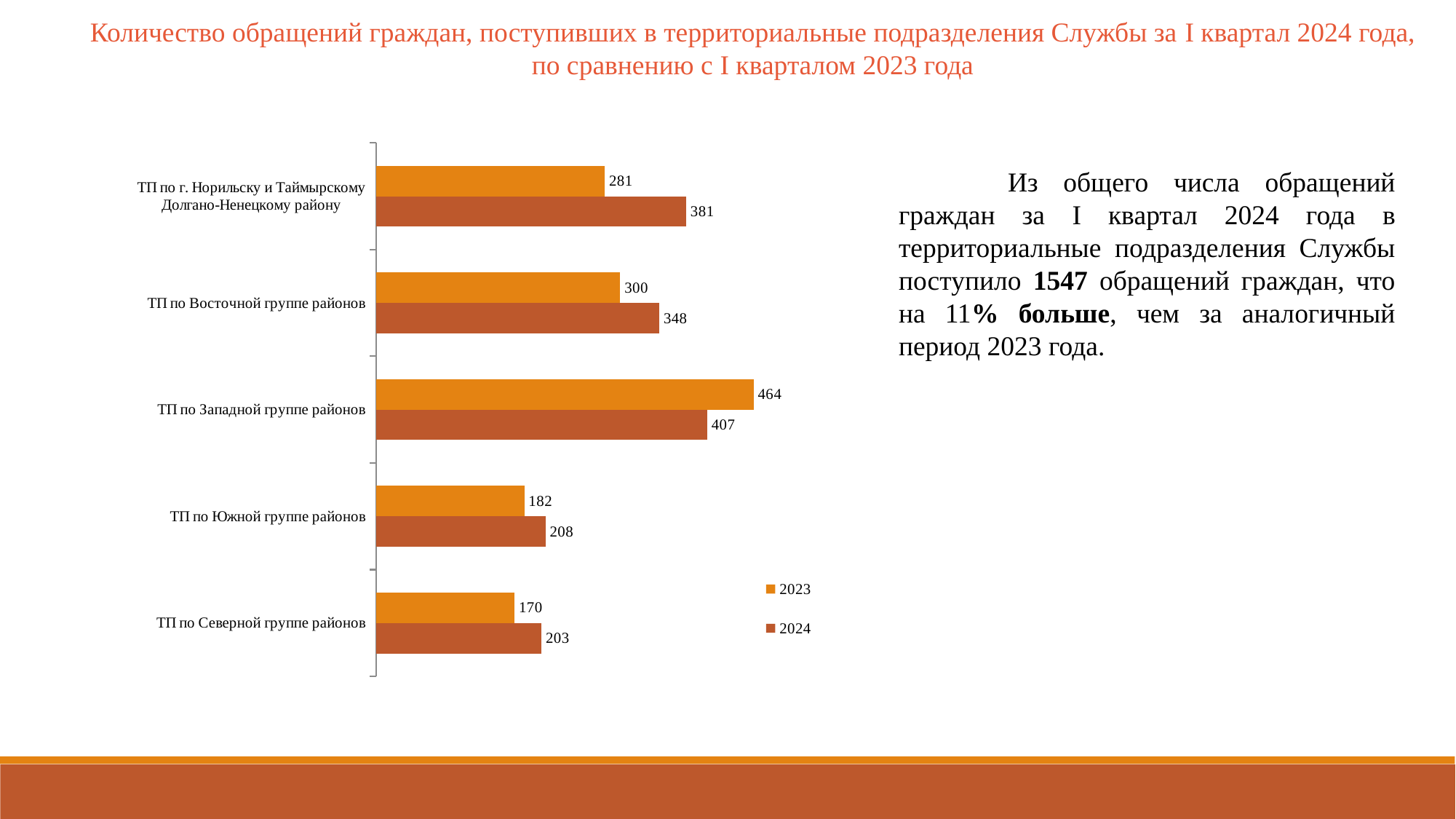
What is the difference between the 2024 and 2023 values for ТП по г. Норильску и Таймырскому Долгано-Ненецкому району? 100 Which category has the lowest 2024 value? ТП по Северной группе районов What is the 2024 value for ТП по Восточной группе районов? 348 What is the difference between the 2023 and 2024 values for ТП по Западной группе районов? 57 What is the 2023 value for ТП по Южной группе районов? 182 Which category has the highest 2023 value? ТП по Западной группе районов How many categories are shown on the chart? 5 What kind of chart is shown on the slide? bar chart Which series is shown in the darker red-brown colour? 2024 How many series does the legend list? 2 Which is larger for ТП по Северной группе районов: the 2023 value or the 2024 value? 2024 What is the 2024 value for ТП по г. Норильску и Таймырскому Долгано-Ненецкому району? 381